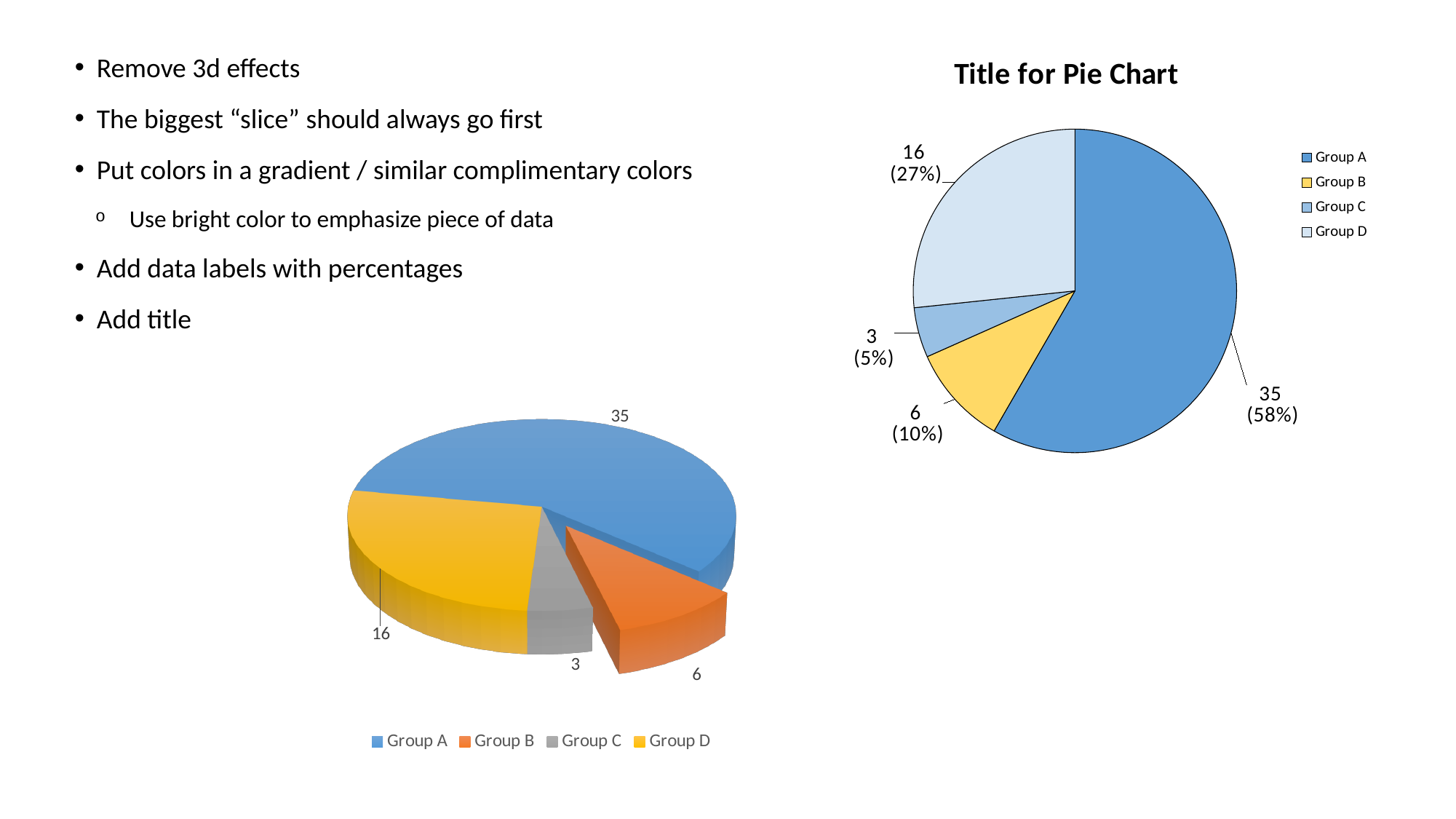
In the chart titled "Title for Pie Chart", what percentage share does Group D have? 27% In the chart titled "Title for Pie Chart", which group has the largest slice? Group A What kind of chart is the chart at the bottom left of the slide? Pie chart In the chart titled "Title for Pie Chart", what percentage share does Group B have? 10% In the chart titled "Title for Pie Chart", what is the value for Group A? 35 In the 3D pie chart at the bottom left of the slide, what is the value for Group B? 6 In the chart titled "Title for Pie Chart", which group has the smallest slice? Group C In the 3D pie chart at the bottom left of the slide, what is the value for Group C? 3 How many groups does the legend of the chart titled "Title for Pie Chart" list? 4 In the 3D pie chart at the bottom left of the slide, which is larger, Group D or Group B? Group D In the 3D pie chart at the bottom left of the slide, what colour is the Group B slice? Orange In the chart titled "Title for Pie Chart", what is the difference between the values for Group A and Group D? 19